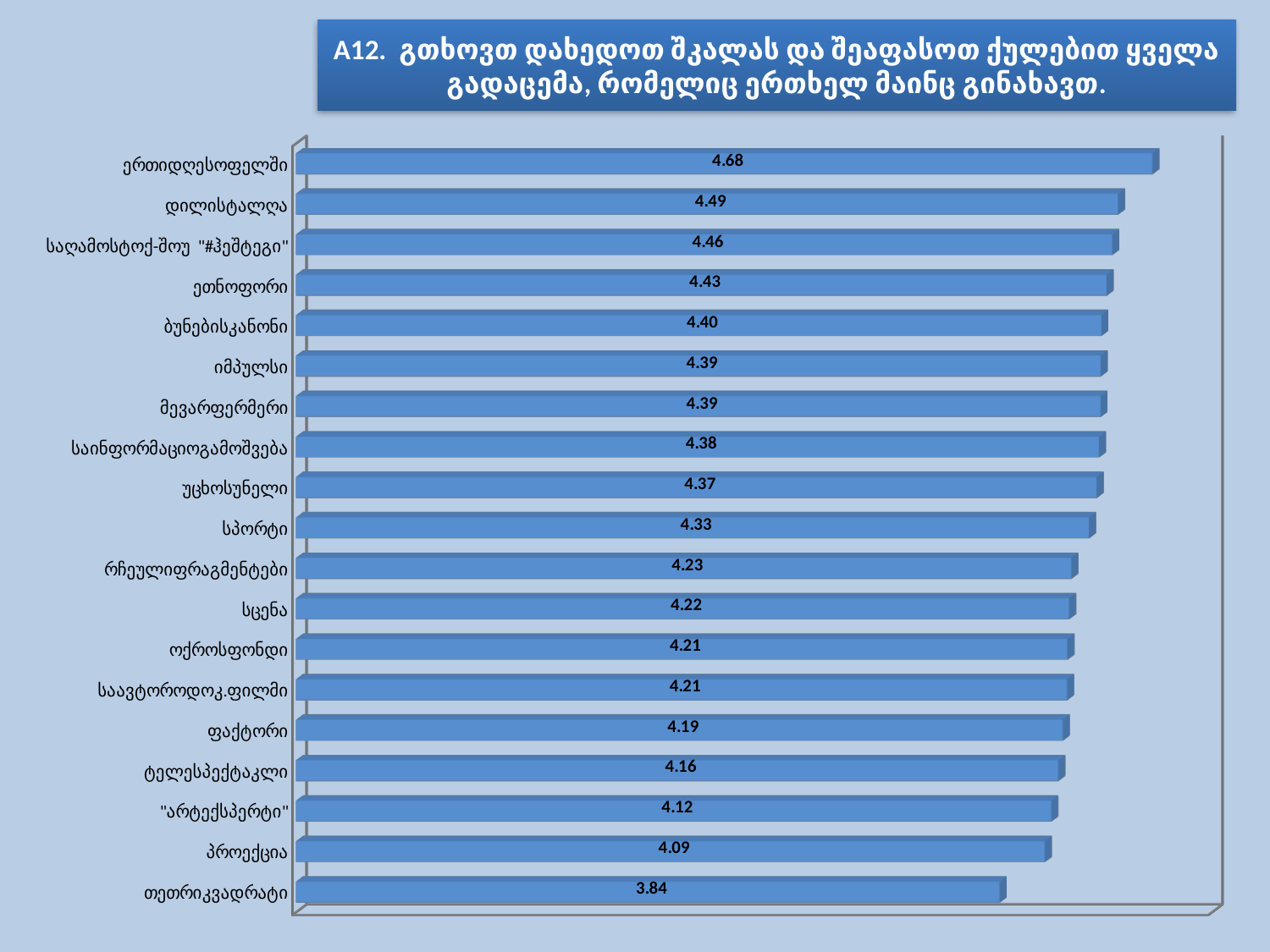
Which has a larger value, ეთნოფორი or სცენა? ეთნოფორი What is the value for ერთიდღესოფელში? 4.68 What is the value for თეთრიკვადრატი? 3.84 Which category has the lowest value? თეთრიკვადრატი What is the value for ფაქტორი? 4.19 How many categories (bars) does the chart show? 19 What is the difference between the values for დილისტალღა and პროექცია? 0.40 Which category has the highest value? ერთიდღესოფელში What is the difference between the values for ერთიდღესოფელში and თეთრიკვადრატი? 0.84 What is the question number shown at the start of the chart title? A12 What is the value for სპორტი? 4.33 What kind of chart is shown on the slide? bar chart